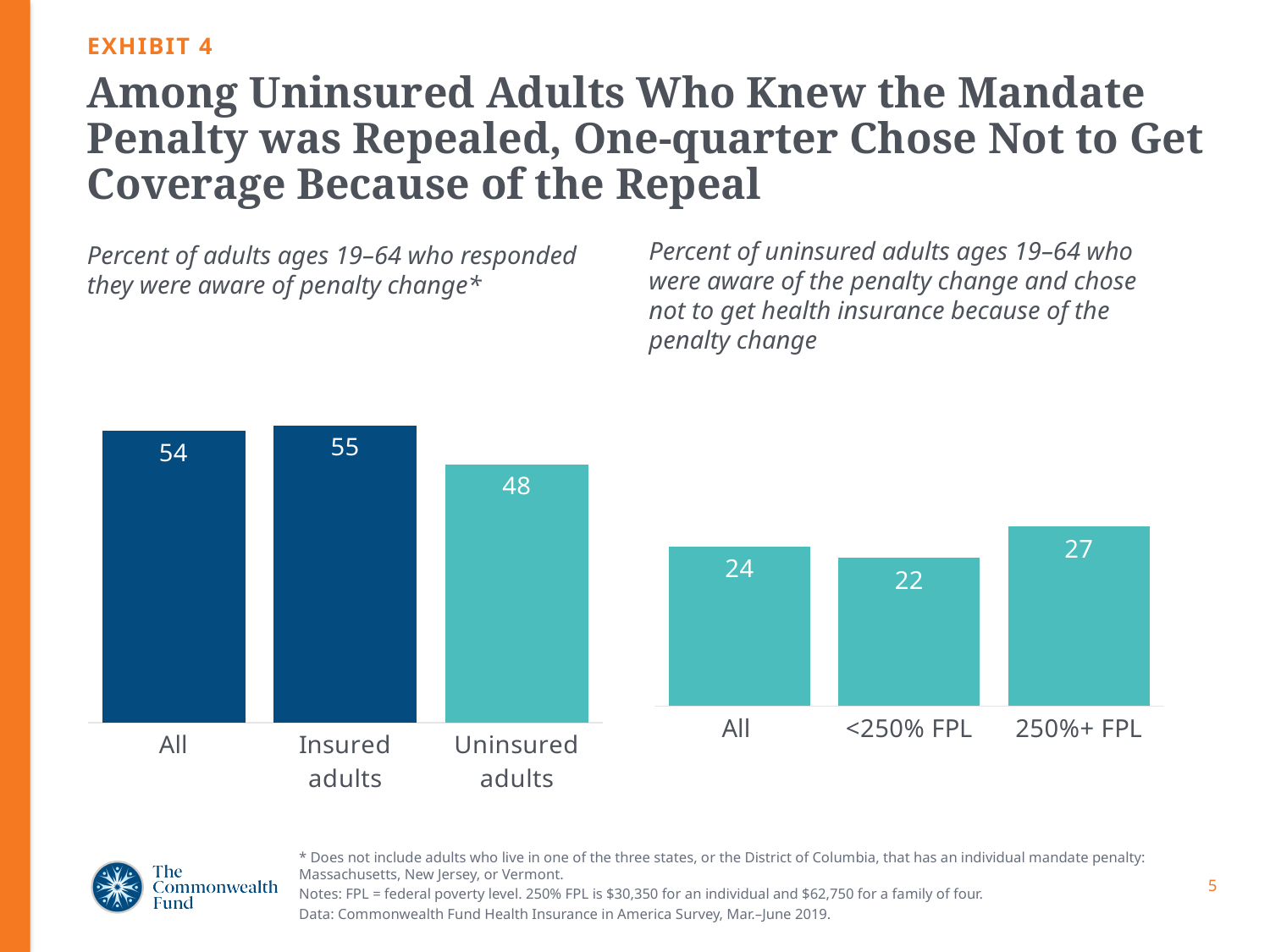
In the right chart (percent of uninsured adults who chose not to get insurance because of the penalty change), which is larger, the value for <250% FPL or the value for 250%+ FPL? 250%+ FPL In the left chart (percent of adults aware of penalty change), what is the value for Uninsured adults? 48 In the right chart (percent of uninsured adults who chose not to get insurance because of the penalty change), what is the value for <250% FPL? 22 What kind of chart is the right chart (percent of uninsured adults who chose not to get insurance because of the penalty change)? Bar chart In the right chart (percent of uninsured adults who chose not to get insurance because of the penalty change), what is the value for All? 24 In the left chart (percent of adults aware of penalty change), what is the difference between the values for Insured adults and Uninsured adults? 7 In the left chart (percent of adults aware of penalty change), how many categories are shown? 3 In the left chart (percent of adults aware of penalty change), which category has the lowest value? Uninsured adults In the right chart (percent of uninsured adults who chose not to get insurance because of the penalty change), which category has the highest value? 250%+ FPL In the right chart (percent of uninsured adults who chose not to get insurance because of the penalty change), what is the difference between the values for 250%+ FPL and <250% FPL? 5 In the left chart (percent of adults aware of penalty change), what is the value for Insured adults? 55 What is the exhibit number shown on the slide? Exhibit 4